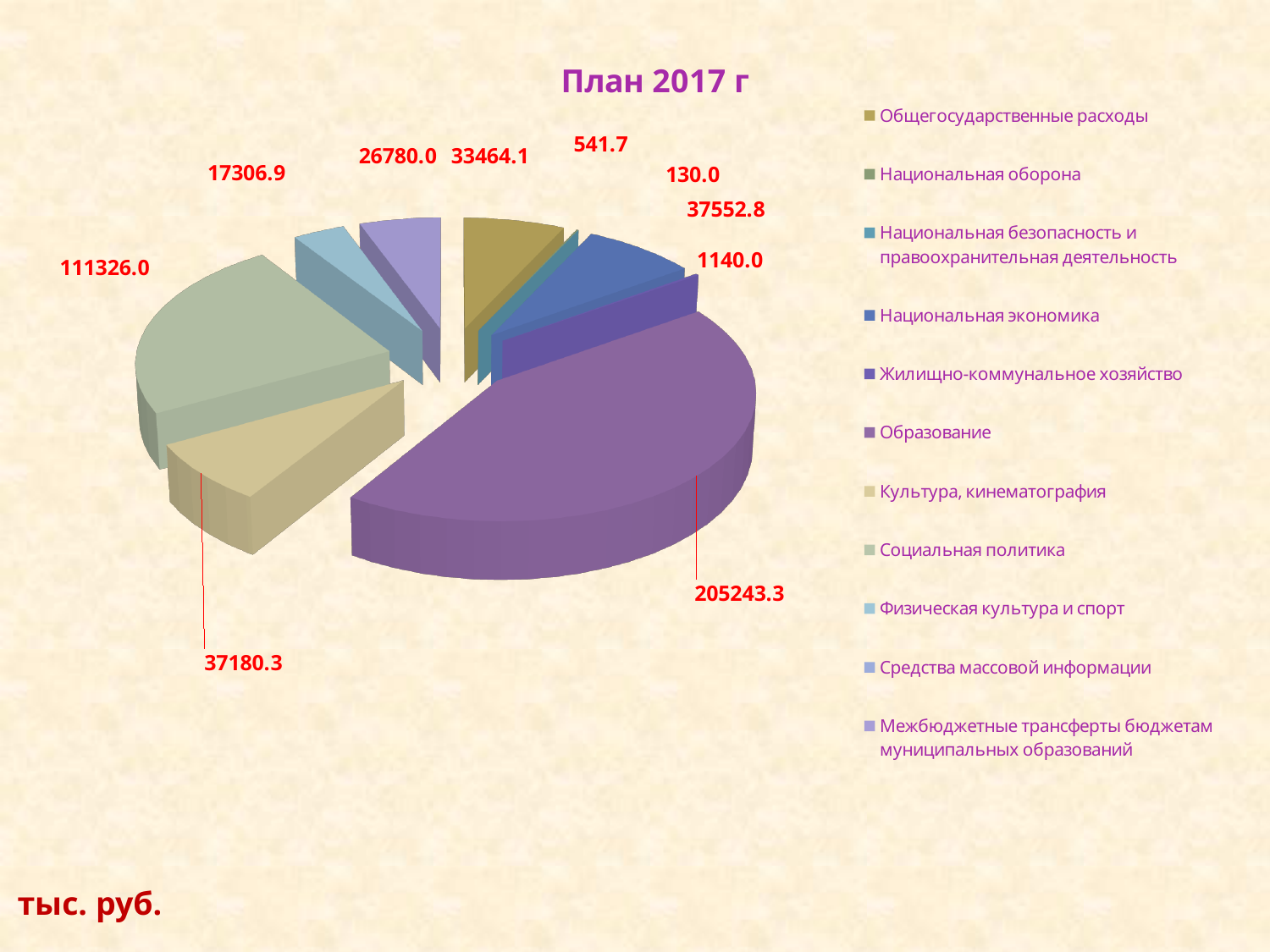
How many categories does the legend list? 11 Which category has the largest slice? Образование What type of chart is shown on the slide? pie chart What is the value for Культура, кинематография? 37180.3 What is the difference between the values for Образование and Социальная политика? 93917.3 What is the title of the chart? План 2017 г What is the value for Образование? 205243.3 Which is larger, Социальная политика or Общегосударственные расходы? Социальная политика What is the value for Национальная экономика? 37552.8 What is the value for Социальная политика? 111326.0 What is the value for Общегосударственные расходы? 33464.1